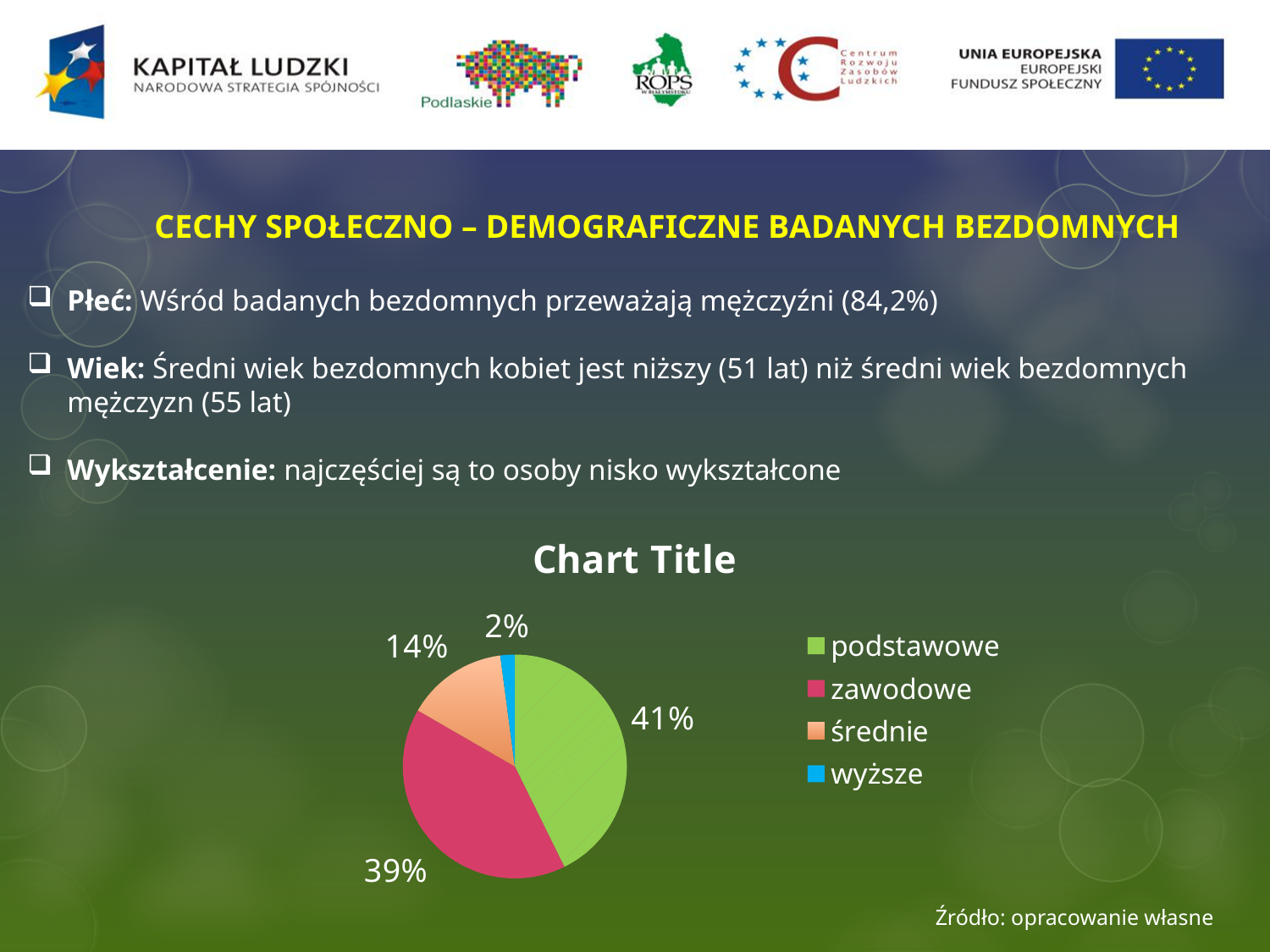
What is the difference in percentage points between the "podstawowe" and "zawodowe" slices? 2 How many categories does the pie chart show? 4 What share of the pie does the "wyższe" slice represent? 2% What kind of chart is shown on the slide? pie chart Which slice is larger, "średnie" or "wyższe"? średnie What share of the pie does the "średnie" slice represent? 14% Which category has the largest slice of the pie? podstawowe What is the title of the chart? Chart Title What share of the pie does the "podstawowe" slice represent? 41% Which category has the smallest slice of the pie? wyższe What is the difference in percentage points between the "średnie" and "wyższe" slices? 12